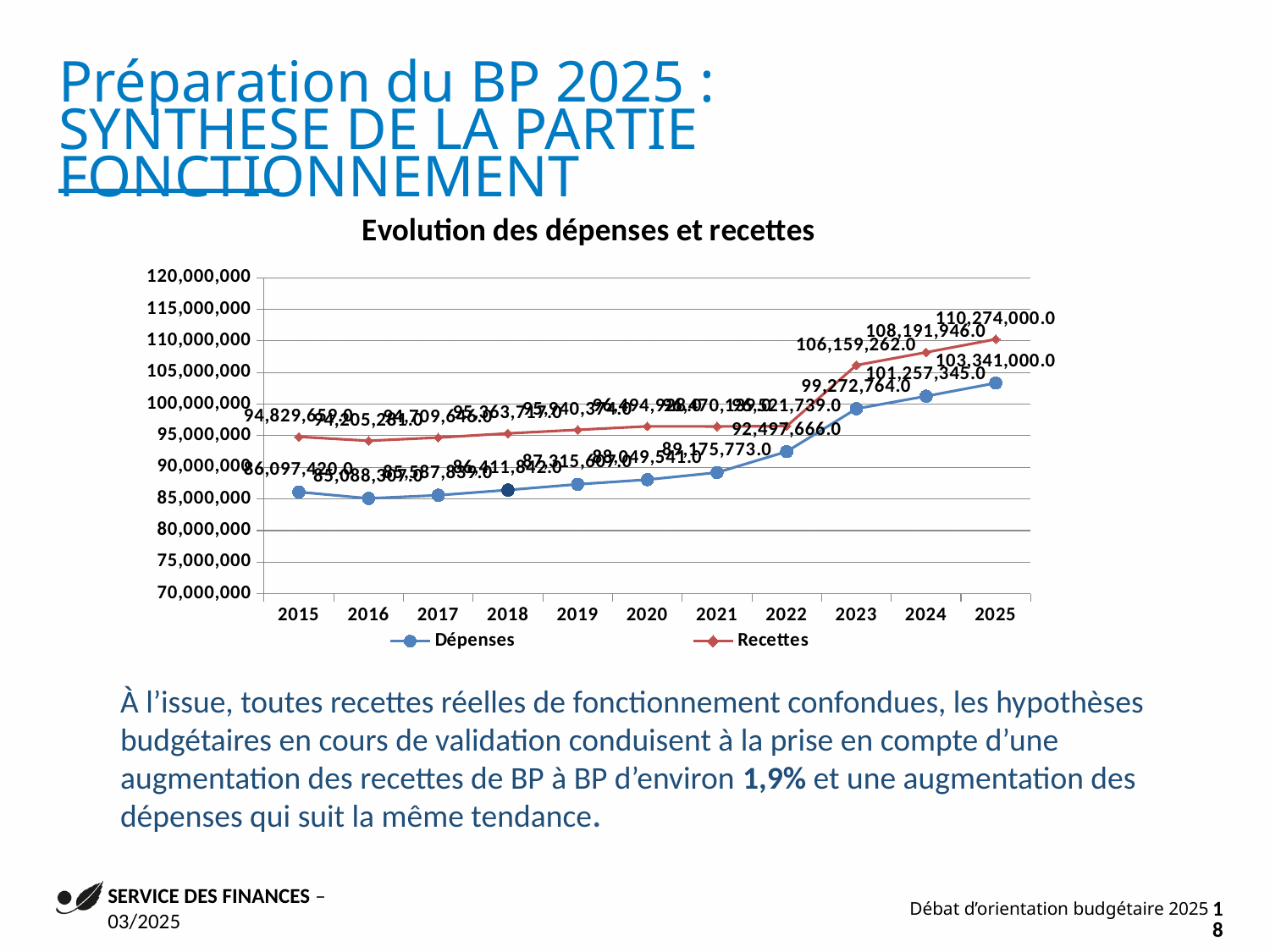
What is the value of Dépenses in 2022? 92,497,666.0 How many years are plotted along the x axis? 11 In which year are Recettes highest? 2025 What is the difference between Recettes and Dépenses in 2025? 6,933,000.0 Is the value for Dépenses in 2016 greater or less than 90,000,000? less What is the value of Recettes in 2025? 110,274,000.0 What kind of chart is shown on the slide? line chart What is the value of Dépenses in 2024? 101,257,345.0 Which is larger in 2023, Recettes or Dépenses? Recettes How many series does the legend list? 2 Do Dépenses generally rise or fall from 2016 to 2025? rise What is the title of the chart? Evolution des dépenses et recettes